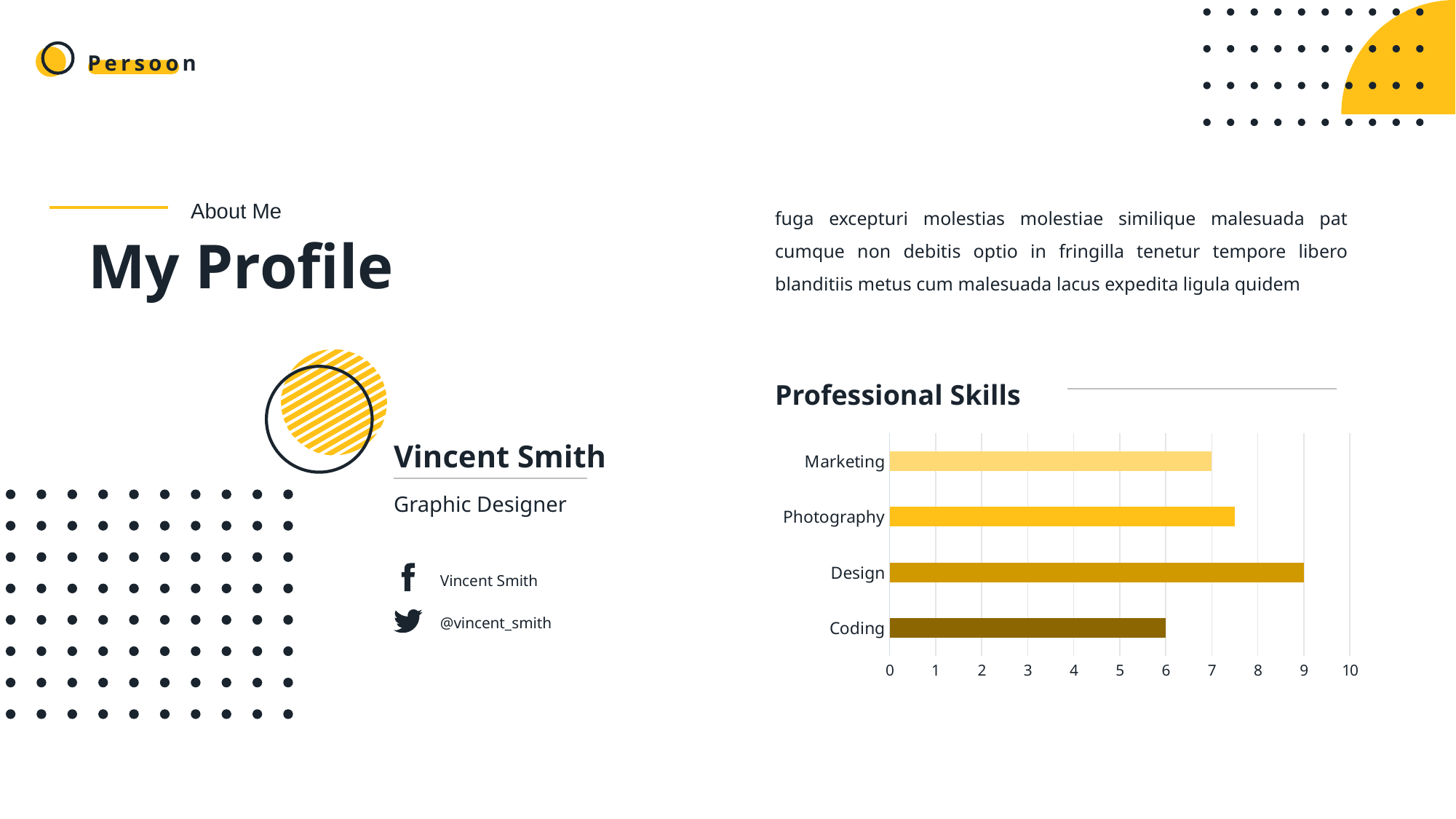
What is the value for Marketing in the Professional Skills chart? 7 How many skill categories does the Professional Skills chart show? 4 What is the value for Design in the Professional Skills chart? 9 Which skill has the highest value in the Professional Skills chart? Design What kind of chart is shown under Professional Skills? bar chart What is the maximum value shown on the x axis of the Professional Skills chart? 10 Which is larger in the Professional Skills chart, Design or Marketing? Design Is the value for Photography greater or less than 8? less Is the value for Photography greater or less than 7? greater Which skill has the lowest value in the Professional Skills chart? Coding What is the difference between the Design and Coding values in the Professional Skills chart? 3 What is the value for Coding in the Professional Skills chart? 6